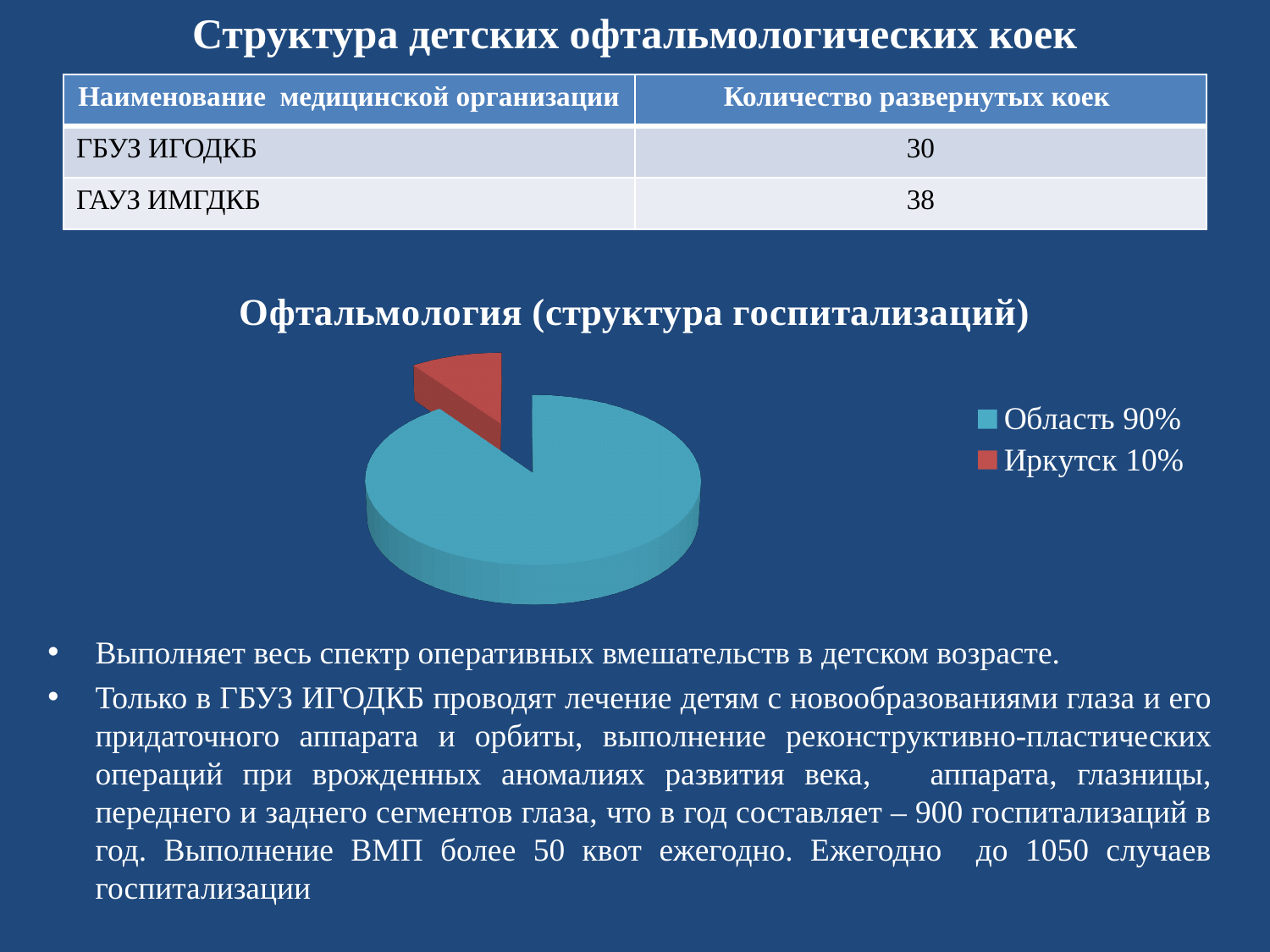
How many entries does the legend of the pie chart list? 2 How many slices does the pie chart have? 2 What is the title of the pie chart on the slide? Офтальмология (структура госпитализаций) In the pie chart, which is larger: the share for "Область" or the share for "Иркутск"? Область What share of the pie chart does "Область" account for? 90% What kind of chart is shown under the title "Офтальмология (структура госпитализаций)"? pie chart What colour is the "Иркутск" slice in the pie chart? red Which slice of the pie chart is the smallest? Иркутск What share of the pie chart does "Иркутск" account for? 10% What is the difference in percentage points between the "Область" share and the "Иркутск" share in the pie chart? 80 Which slice of the pie chart is the largest? Область